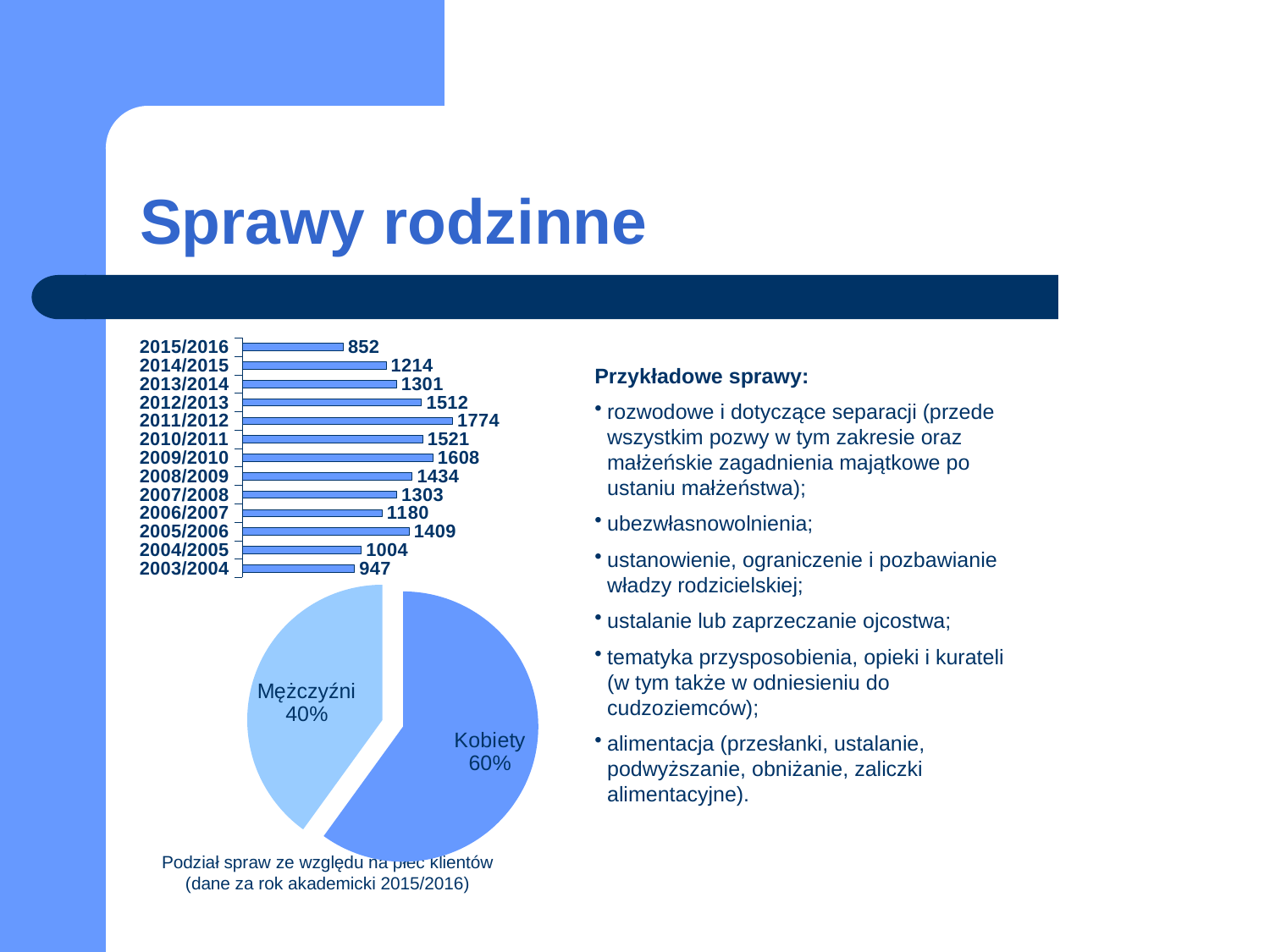
In the bar chart at the top left, what is the value for 2011/2012? 1774 In the bar chart at the top left, what is the value for 2015/2016? 852 In the bar chart at the top left, what is the difference between the values for 2011/2012 and 2015/2016? 922 In the pie chart titled 'Podział spraw ze względu na płeć klientów', how many slices are there? 2 In the bar chart at the top left, what is the value for 2003/2004? 947 In the bar chart at the top left, which academic year has the lowest value? 2015/2016 What kind of chart is the chart at the top left of the slide? Bar chart In the bar chart at the top left, how many academic years are shown? 13 In the bar chart at the top left, which is larger: the value for 2009/2010 or the value for 2010/2011? 2009/2010 In the pie chart titled 'Podział spraw ze względu na płeć klientów', what share is Mężczyźni? 40% In the pie chart titled 'Podział spraw ze względu na płeć klientów', what share is Kobiety? 60% In the bar chart at the top left, which academic year has the highest value? 2011/2012